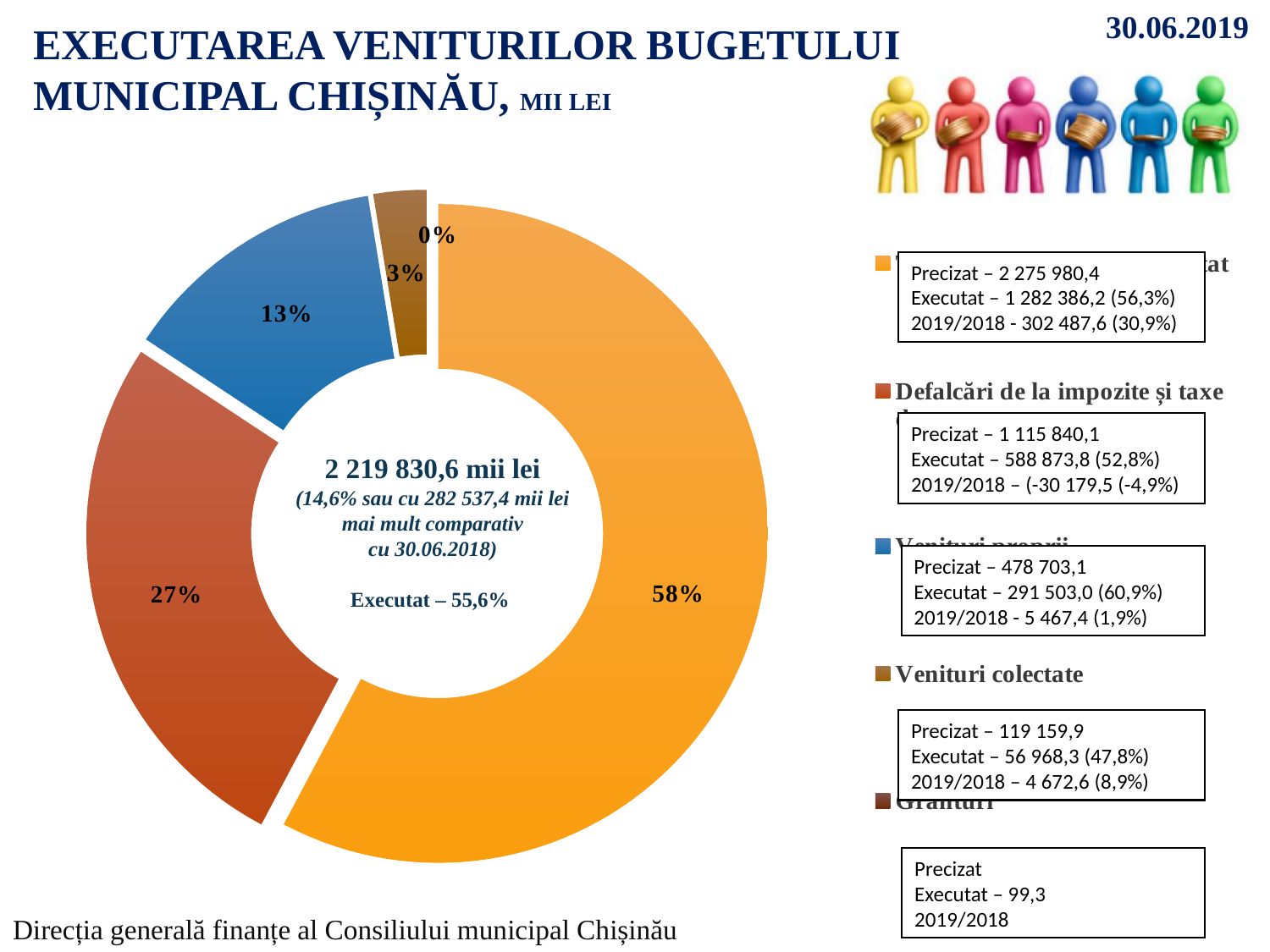
What is the largest share shown on the doughnut chart? 58% How many entries does the legend of the chart list? 5 What execution percentage ('Executat') is printed in the centre of the chart? 55,6% What is the smallest share shown on the doughnut chart? 0% What share of the chart does 'Venituri colectate' represent? 3% How many slices does the doughnut chart have? 5 What share of the chart does 'Defalcări de la impozite și taxe' represent? 27% What kind of chart is shown on the slide? Doughnut (pie) chart What total value is printed in the centre of the doughnut chart? 2 219 830,6 mii lei What is the difference in percentage points between the largest slice (58%) and the 27% slice? 31 percentage points Which is larger: the blue slice or the 'Venituri colectate' slice? The blue slice (13%) What date is shown in the top right corner of the slide? 30.06.2019